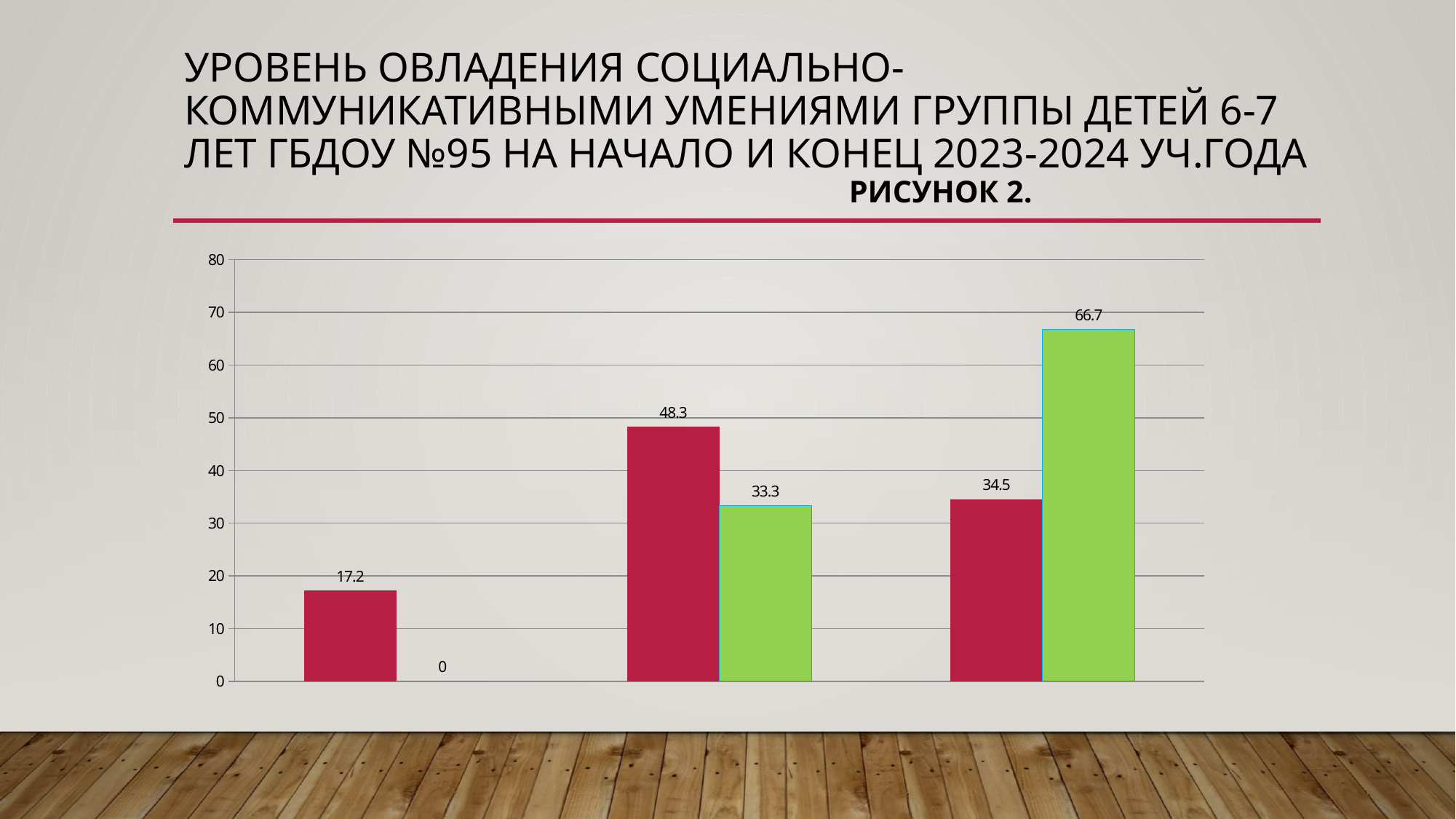
What type of chart is shown on the slide? bar chart What is the value of the green bar in the third (rightmost) group? 66.7 What is the difference between the red bar and the green bar in the second (middle) group? 15 In the second (middle) group, which bar is larger, the red one or the green one? the red one What is the value of the green bar in the first (leftmost) group? 0 Which bar has the highest value in the chart? the green bar in the third group (66.7) Is the value of the green bar in the third group greater or less than 60? greater What is the value of the red bar in the first (leftmost) group? 17.2 How many groups of bars are plotted in the chart? 3 What is the highest value shown on the vertical axis? 80 What is the value of the red bar in the second (middle) group? 48.3 What is the difference between the green bar and the red bar in the third (rightmost) group? 32.2